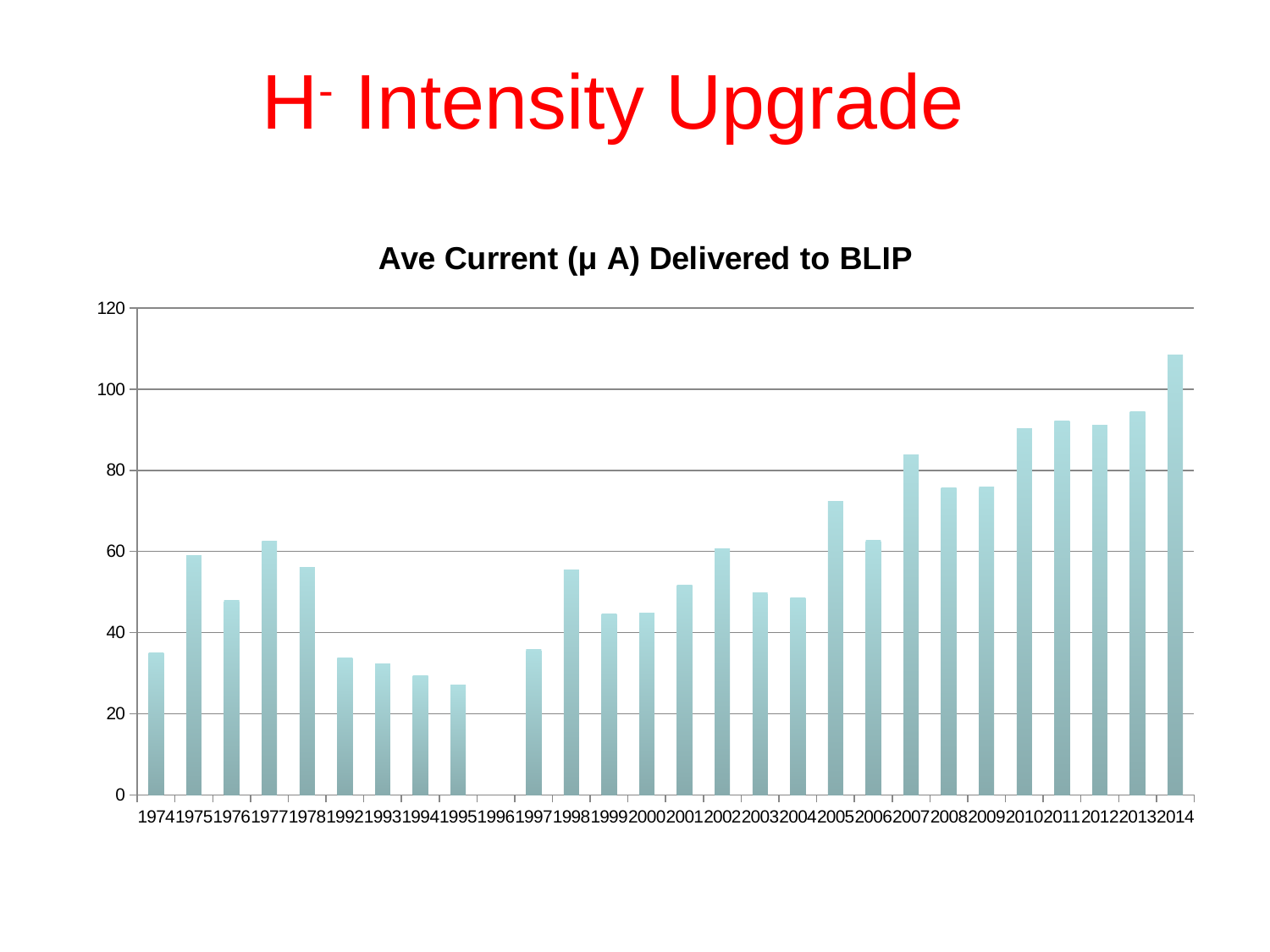
What is the title of the chart? Ave Current (μ A) Delivered to BLIP Is the value for 1998 greater or less than 60? less Is the value for 2014 greater or less than 100? greater Which year has the lowest bar in the chart? 1995 Which year has the larger value, 1977 or 1992? 1977 Do the values generally rise or fall from 2005 to 2014? rise Which year has the larger value, 2005 or 2006? 2005 What kind of chart is shown on the slide? bar chart Which year has the highest average current delivered to BLIP? 2014 Is the value for 2007 greater or less than 80? greater How many years are labeled on the x axis? 28